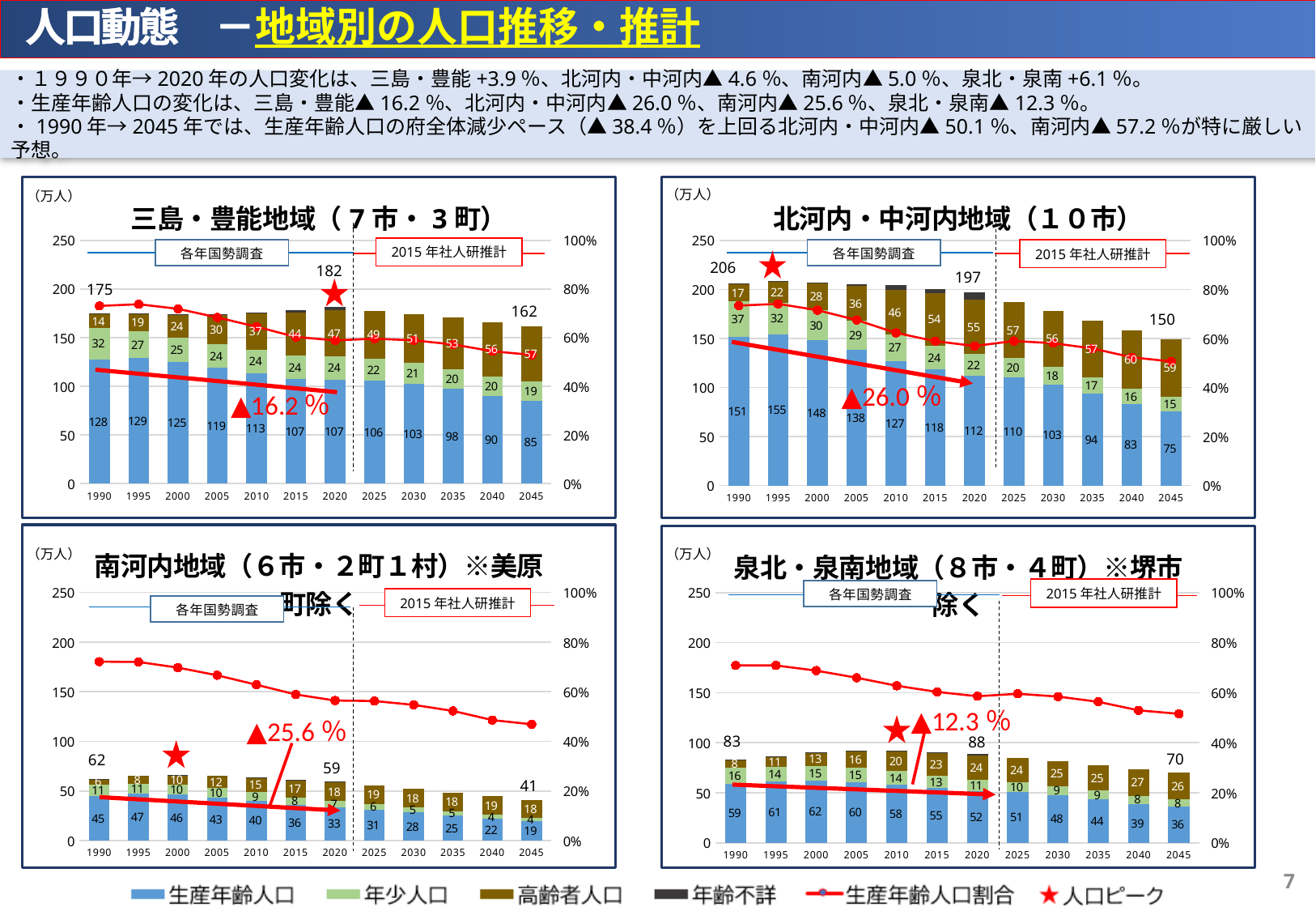
How many years are shown on the x axis of the 北河内・中河内地域 chart (top right)? 12 In the 南河内地域 chart (bottom left), what is the total population labeled for 2045? 41 What kind of chart is the 南河内地域 chart (bottom left)? Stacked bar chart with a line In the 三島・豊能地域 chart (top left), what is the difference between the 生産年齢人口 values for 1990 and 2045? 43 In the 三島・豊能地域 chart (top left), what is the 生産年齢人口 value for 1990? 128 How many entries does the shared legend at the bottom of the slide list? 6 In the 北河内・中河内地域 chart (top right), which year has the lowest 年少人口 value? 2045 In the 三島・豊能地域 chart (top left), does the 生産年齢人口 value rise or fall from 2020 to 2045? fall In the 北河内・中河内地域 chart (top right), what is the 高齢者人口 value for 2045? 59 In the 泉北・泉南地域 chart (bottom right), which year has the highest 生産年齢人口 value? 2000 In the 南河内地域 chart (bottom left), which is larger: the 高齢者人口 value for 2020 or the 年少人口 value for 2020? 高齢者人口 (18) In the 泉北・泉南地域 chart (bottom right), is the total bar height for 2045 greater or less than 100? less